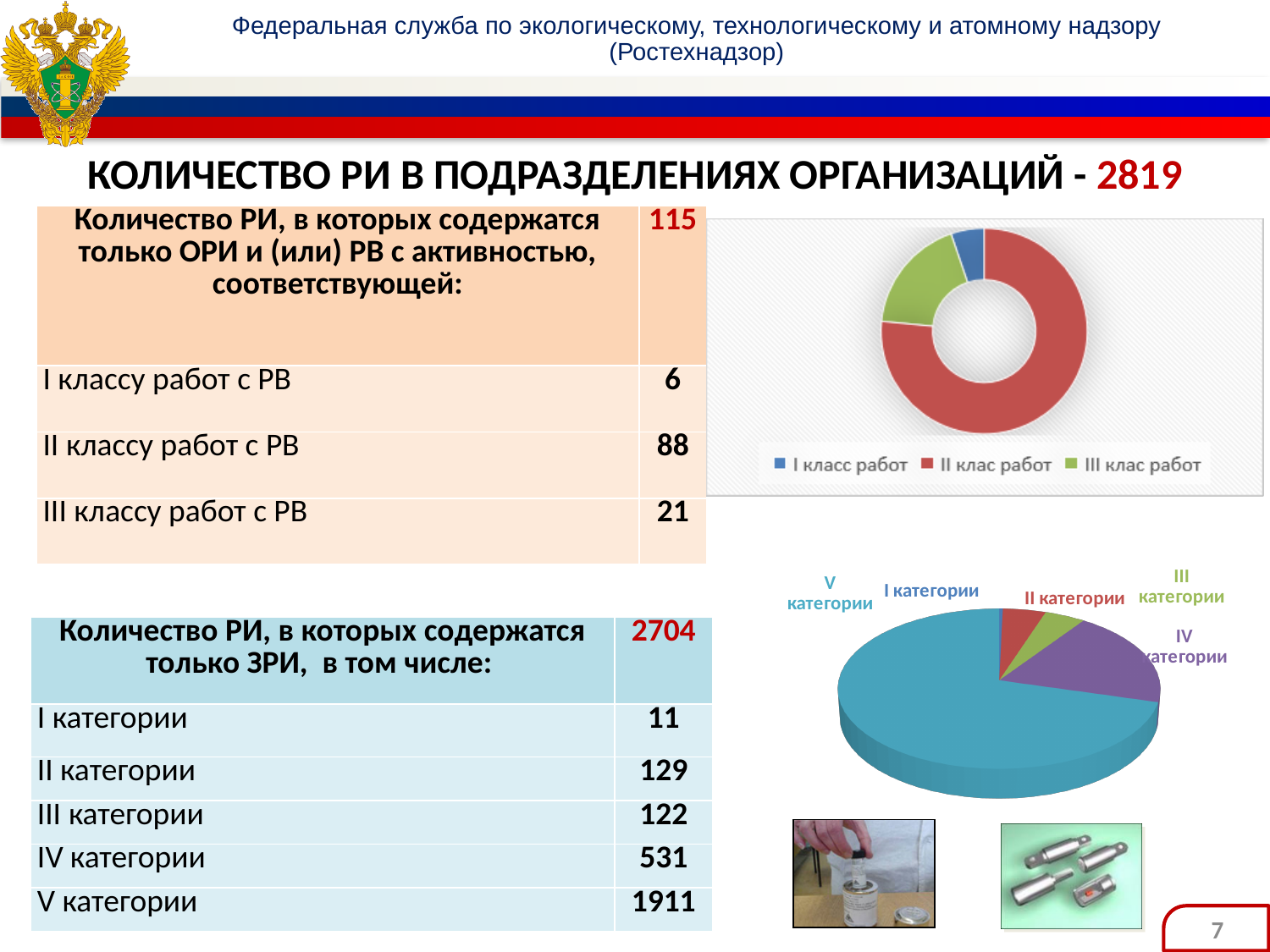
How many categories are shown in the bottom-right pie chart? 5 In the bottom-right pie chart, which category has the smallest slice? I категории According to the table next to the top-right doughnut chart, what is the value for II классу работ с РВ? 88 What kind of chart is the chart in the bottom right of the slide? pie chart In the top-right doughnut chart, which class of work has the smallest slice? I класс работ In the top-right doughnut chart, which class of work has the largest slice? II клас работ What kind of chart is the chart in the top right of the slide? doughnut chart According to the table next to the bottom-right pie chart, what is the value for V категории? 1911 How many entries does the legend of the top-right doughnut chart list? 3 In the top-right doughnut chart, what colour is the slice for II клас работ? red In the bottom-right pie chart, which category has the largest slice? V категории In the bottom-right pie chart, which slice is larger: IV категории or II категории? IV категории